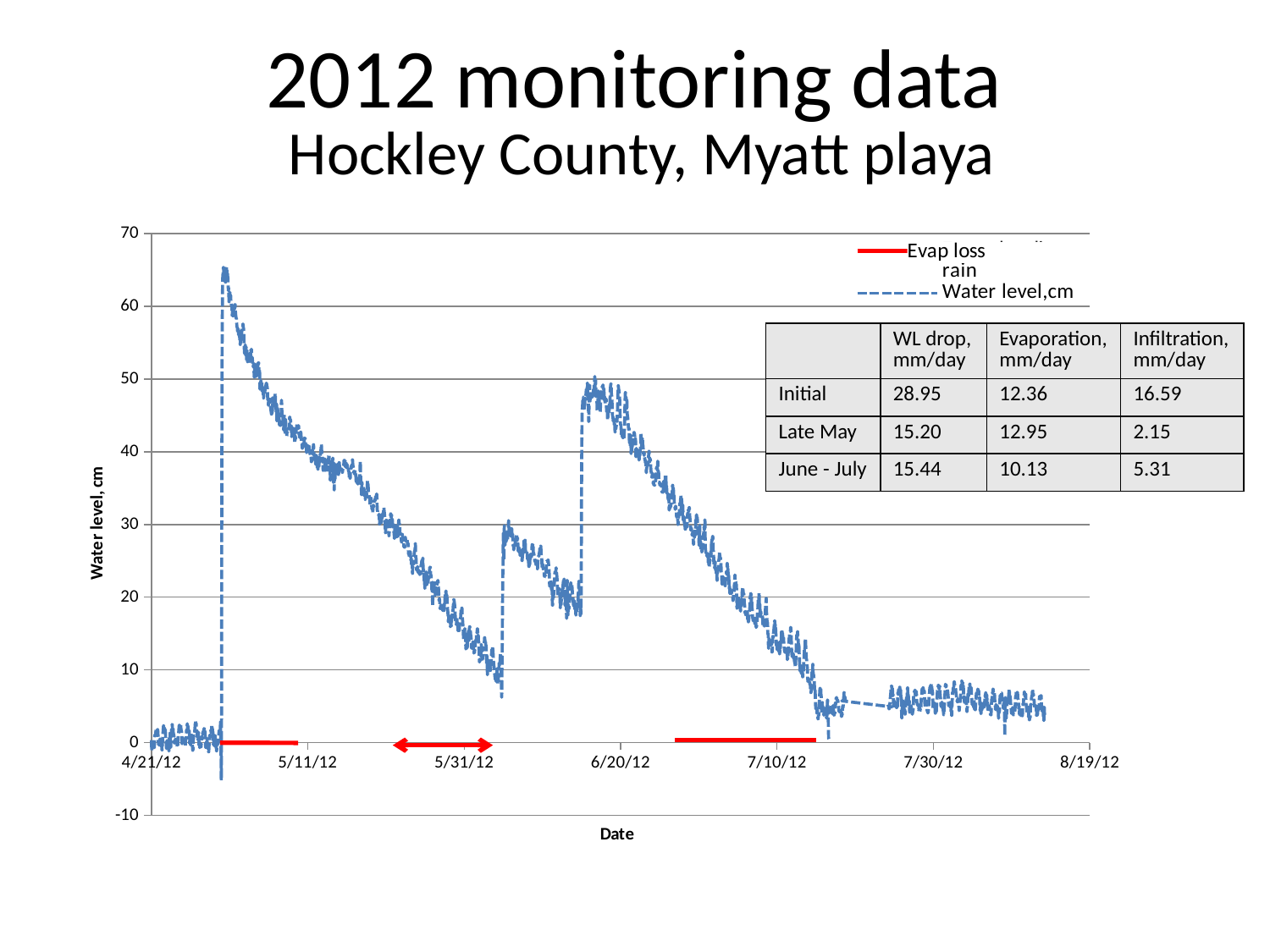
Does the water level rise or fall between 6/20/12 and 7/10/12? fall In the table on the chart, what is the WL drop in mm/day for the Initial period? 28.95 What is the label of the y axis of the chart? Water level, cm What kind of chart is shown on the slide? line chart Is the water level around 5/31/12 greater or less than 20? less What is the label of the x axis of the chart? Date How many series does the chart legend list? 2 Does the water level rise or fall between 5/11/12 and 5/31/12? fall In the table on the chart, what is the Infiltration in mm/day for Late May? 2.15 Is the highest water level reached on the chart greater or less than 60? greater Is the water level around 6/20/12 greater or less than 40? greater